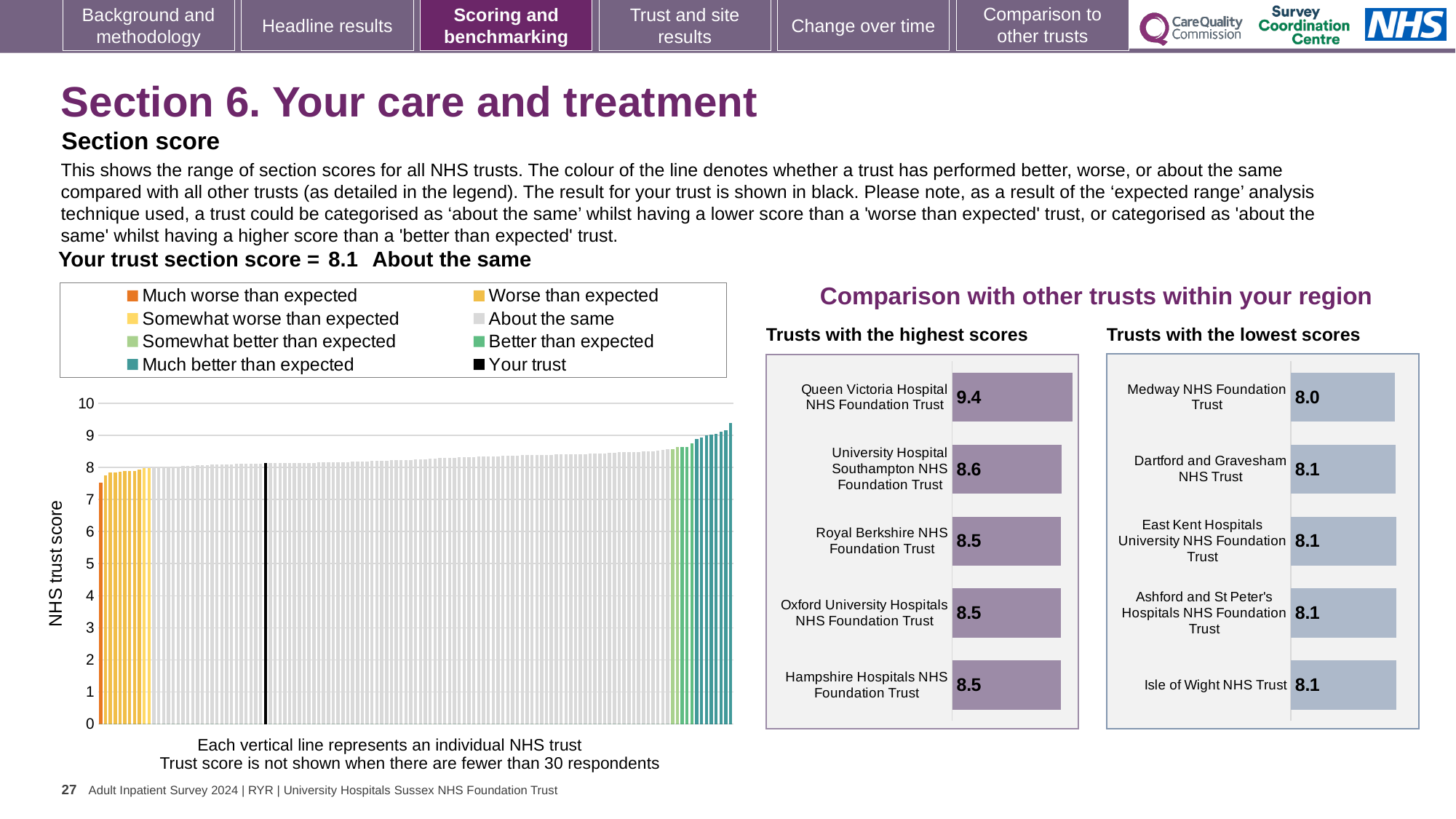
In the 'Trusts with the highest scores' chart, what is the score for University Hospital Southampton NHS Foundation Trust? 8.6 In the 'Trusts with the lowest scores' chart, what is the score for Isle of Wight NHS Trust? 8.1 In the 'Trusts with the highest scores' chart, what is the score for Queen Victoria Hospital NHS Foundation Trust? 9.4 In the 'Trusts with the highest scores' chart, how many trusts are shown? 5 In the 'Trusts with the highest scores' chart, what is the difference between the scores of Queen Victoria Hospital NHS Foundation Trust and University Hospital Southampton NHS Foundation Trust? 0.8 What kind of chart is the large chart on the left showing NHS trust scores? Bar chart In the 'Trusts with the lowest scores' chart, what is the score for Medway NHS Foundation Trust? 8.0 In the large chart on the left showing NHS trust scores, is the value of the tallest bar greater or less than 9? greater In the 'Trusts with the lowest scores' chart, which is larger: the score for Dartford and Gravesham NHS Trust or the score for Medway NHS Foundation Trust? Dartford and Gravesham NHS Trust In the large chart on the left showing NHS trust scores, how many entries does the legend list? 8 In the 'Trusts with the lowest scores' chart, which trust has the lowest score? Medway NHS Foundation Trust In the 'Trusts with the highest scores' chart, which trust has the highest score? Queen Victoria Hospital NHS Foundation Trust